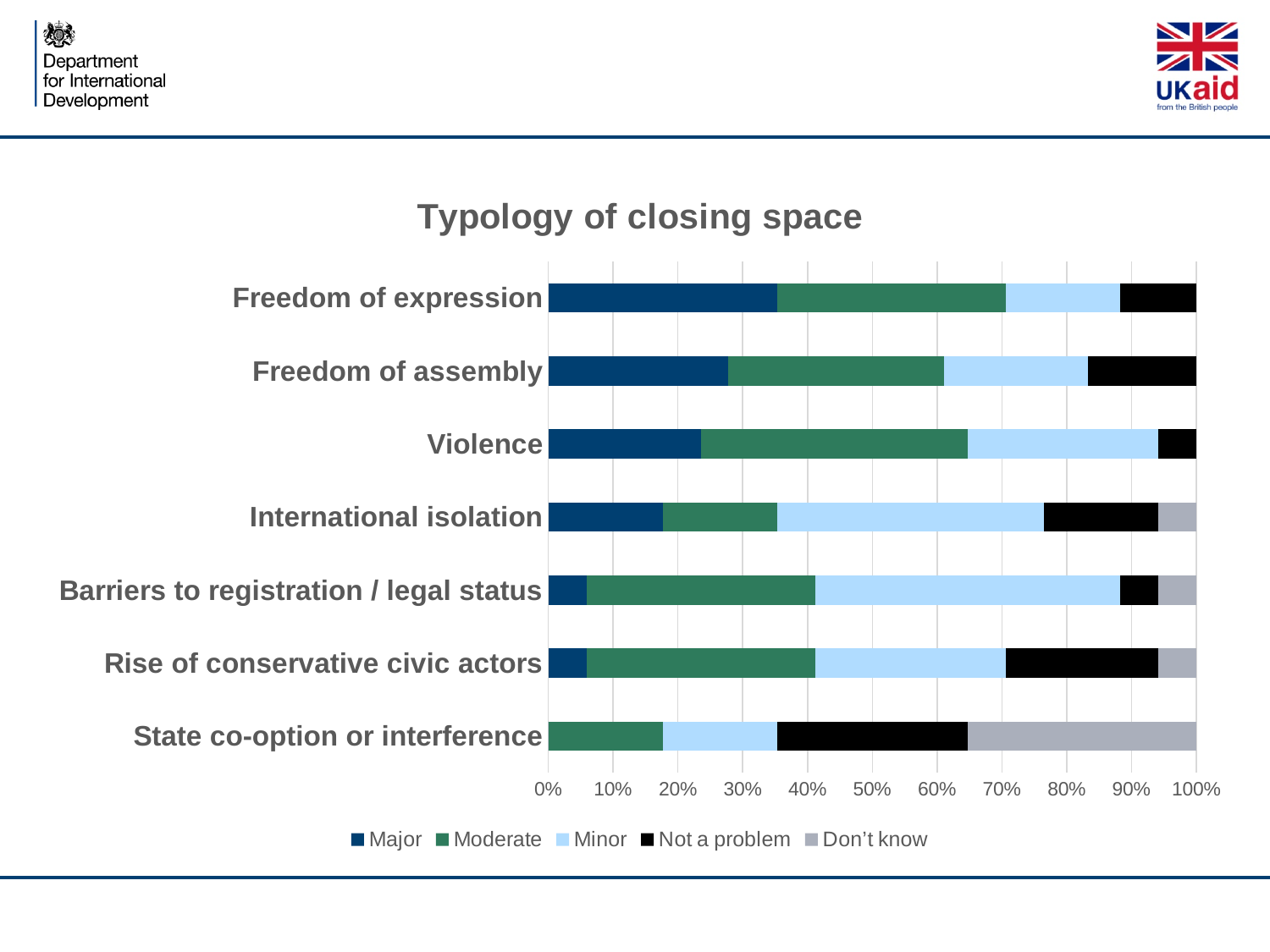
How many series does the legend list? 5 What is the title of the chart? Typology of closing space Which colour represents 'Not a problem' in the legend? Black How many categories are plotted on the chart? 7 Which category has the largest 'Major' share? Freedom of expression Is the 'Don't know' share for State co-option or interference greater or less than 20%? greater What kind of chart is shown on the slide? Stacked bar chart Is the 'Major' share for Violence greater or less than 30%? less Which category has the largest 'Don't know' share? State co-option or interference Which has the larger 'Major' share: Freedom of expression or Freedom of assembly? Freedom of expression Which category has no 'Major' segment at all? State co-option or interference Is the 'Major' share for Freedom of expression greater or less than 30%? greater